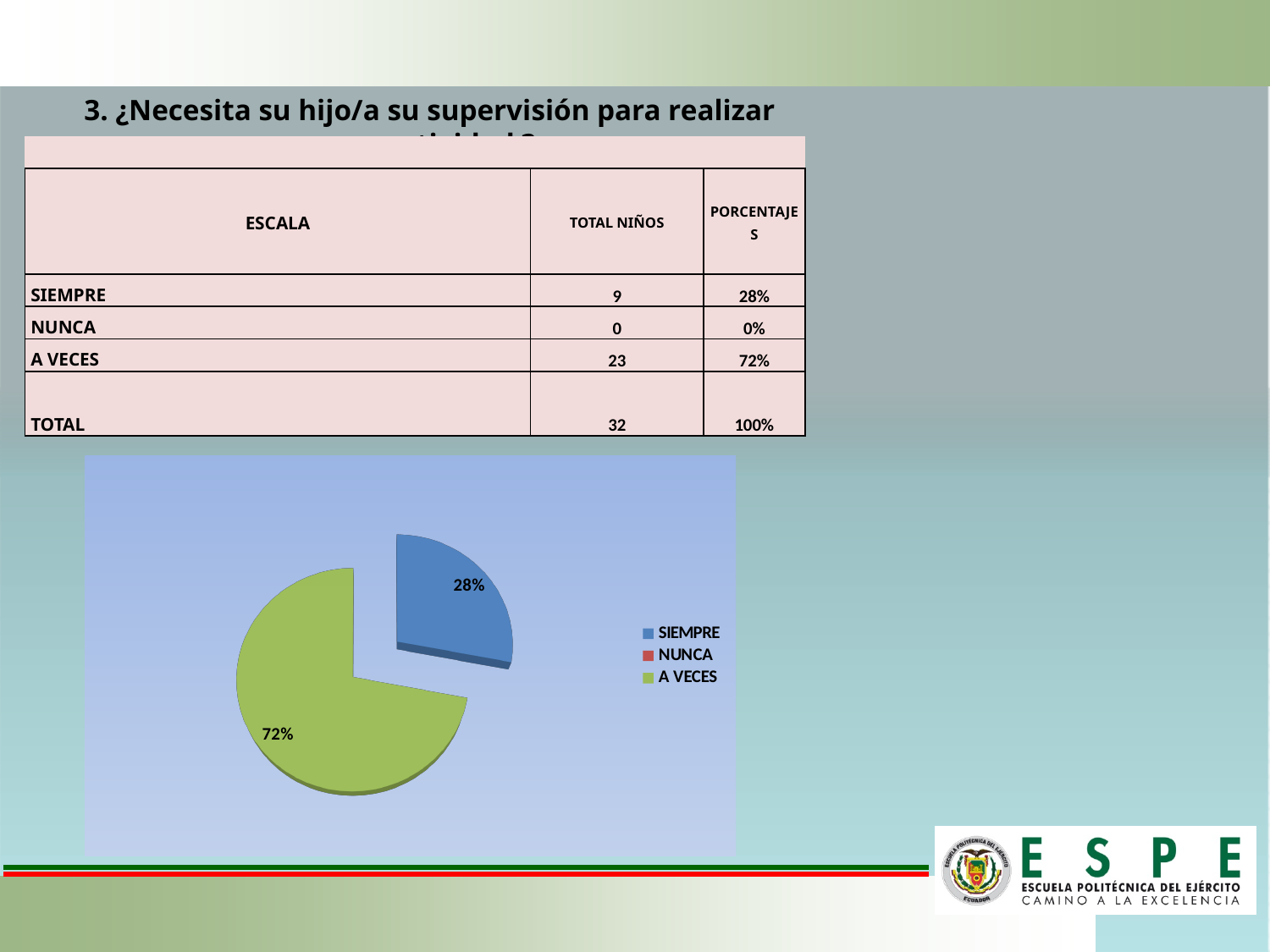
How many entries does the legend list? 3 What share of the pie does SIEMPRE represent? 28% Which of SIEMPRE or A VECES has the larger slice? A VECES What colour is the A VECES slice? green Which category has the largest slice of the pie? A VECES What is the difference in percentage points between the A VECES slice and the SIEMPRE slice? 44 What kind of chart is shown on the slide? pie chart What share of the pie does A VECES represent? 72% Which legend entry does not have a visible slice in the pie? NUNCA Is the share for SIEMPRE greater or less than 50%? less